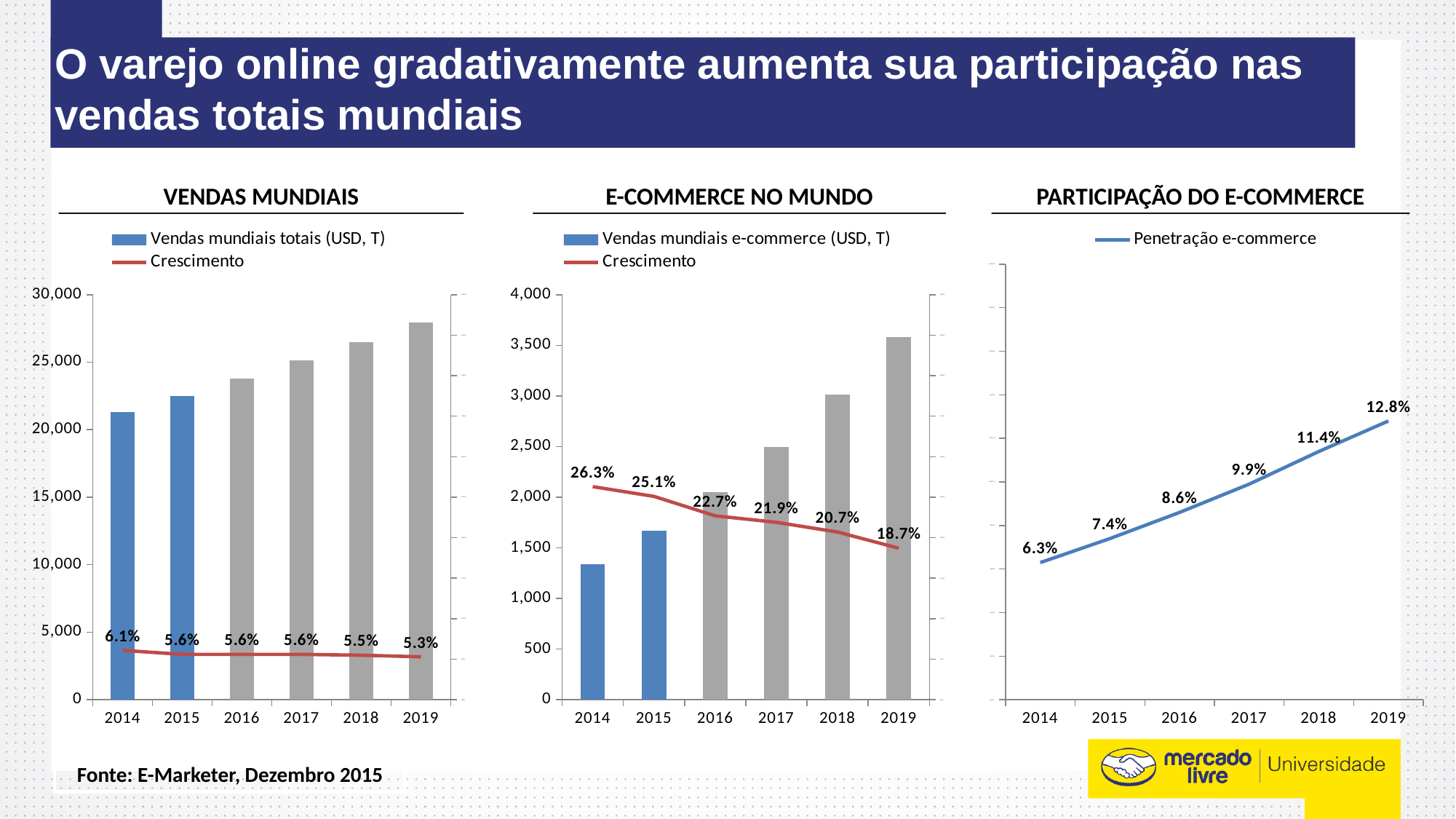
In the E-COMMERCE NO MUNDO chart, does the Crescimento line rise or fall from 2014 to 2019? fall What kind of chart is the PARTICIPAÇÃO DO E-COMMERCE chart? line chart In the E-COMMERCE NO MUNDO chart, what is the Crescimento value for 2016? 22.7% In the E-COMMERCE NO MUNDO chart, what is the difference between the Crescimento values for 2014 and 2019? 7.6 percentage points In the PARTICIPAÇÃO DO E-COMMERCE chart, how many years are plotted on the x axis? 6 In the VENDAS MUNDIAIS chart, is the value of Vendas mundiais totais for 2014 greater or less than 20,000? greater In the VENDAS MUNDIAIS chart, what is the Crescimento value for 2014? 6.1% In the PARTICIPAÇÃO DO E-COMMERCE chart, what is the Penetração e-commerce value for 2017? 9.9% In the E-COMMERCE NO MUNDO chart, is the value of Vendas mundiais e-commerce for 2014 greater or less than 1,500? less In the PARTICIPAÇÃO DO E-COMMERCE chart, which year has the highest Penetração e-commerce value? 2019 In the VENDAS MUNDIAIS chart, which year has the lowest Crescimento value? 2019 In the VENDAS MUNDIAIS chart, how many series does the legend list? 2